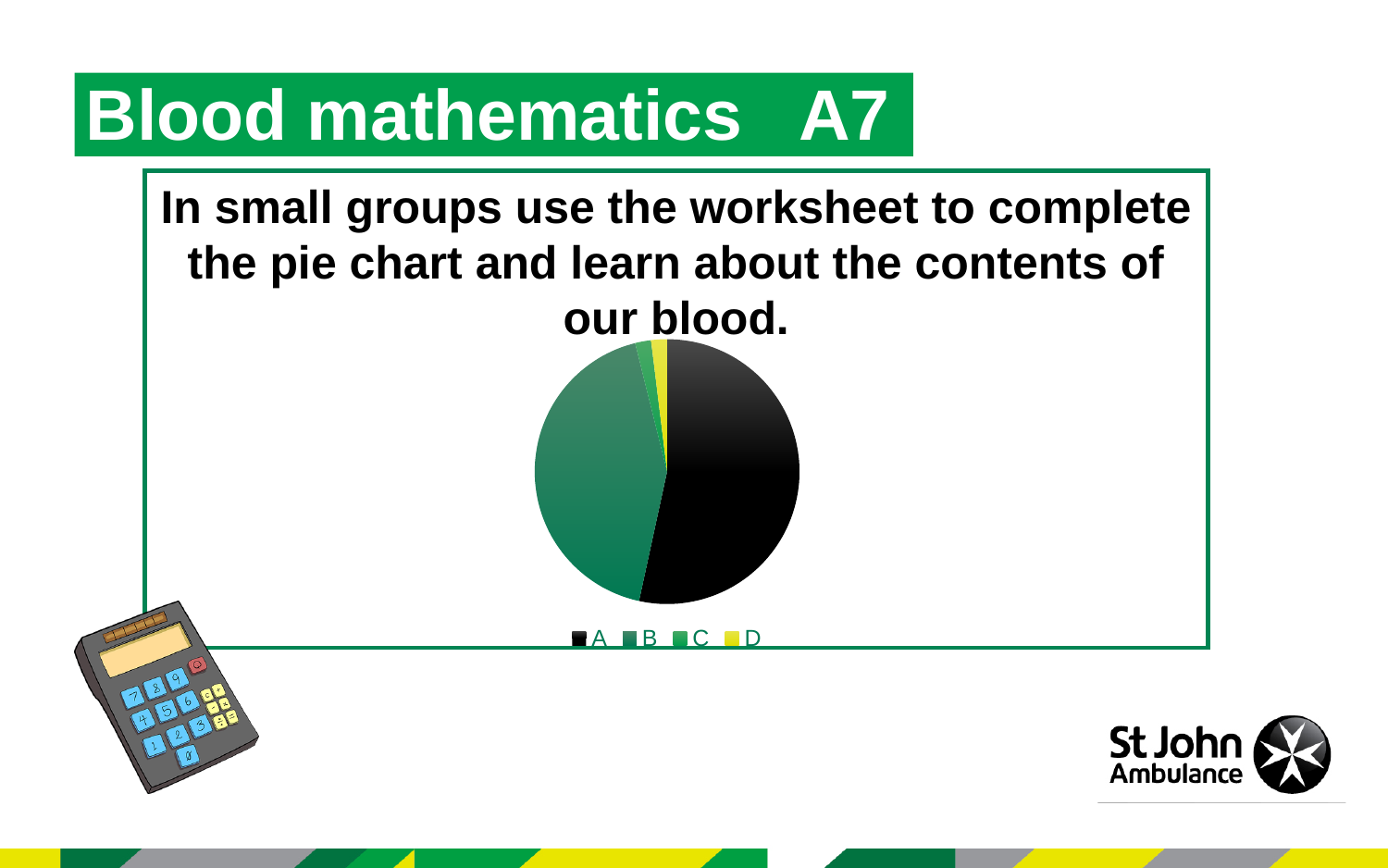
Which slice is larger in the pie chart, A or B? A What kind of chart is shown on the slide? pie chart How many categories does the pie chart's legend list? 4 Which slice is larger in the pie chart, B or D? B What are the legend entries of the pie chart? A, B, C, D What colour is slice A in the pie chart? black Which slice is larger in the pie chart, A or C? A Which category has the largest slice of the pie chart? A